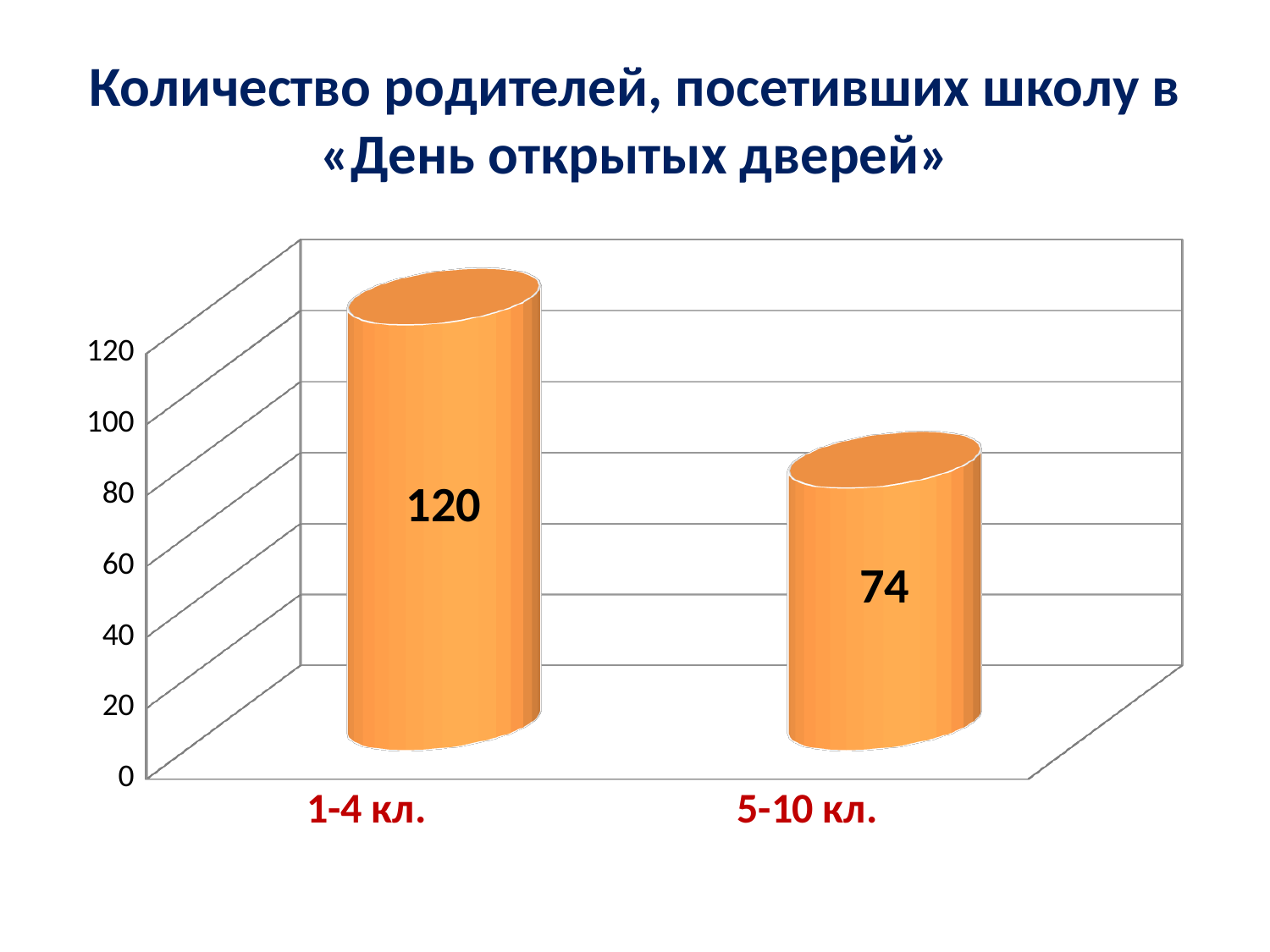
What is the value for 5-10 кл.? 74 Do the values rise or fall from 1-4 кл. to 5-10 кл.? fall Is the value for 1-4 кл. greater or less than 100? greater Which category has the lowest value? 5-10 кл. What is the difference between the values for 1-4 кл. and 5-10 кл.? 46 What kind of chart is shown on the slide? bar chart What is the value for 1-4 кл.? 120 How many categories are shown on the x axis? 2 Is the value for 5-10 кл. greater or less than 80? less Which category has the highest value? 1-4 кл. What is the title of the chart on the slide? Количество родителей, посетивших школу в «День открытых дверей» Which is larger, the value for 1-4 кл. or the value for 5-10 кл.? 1-4 кл.